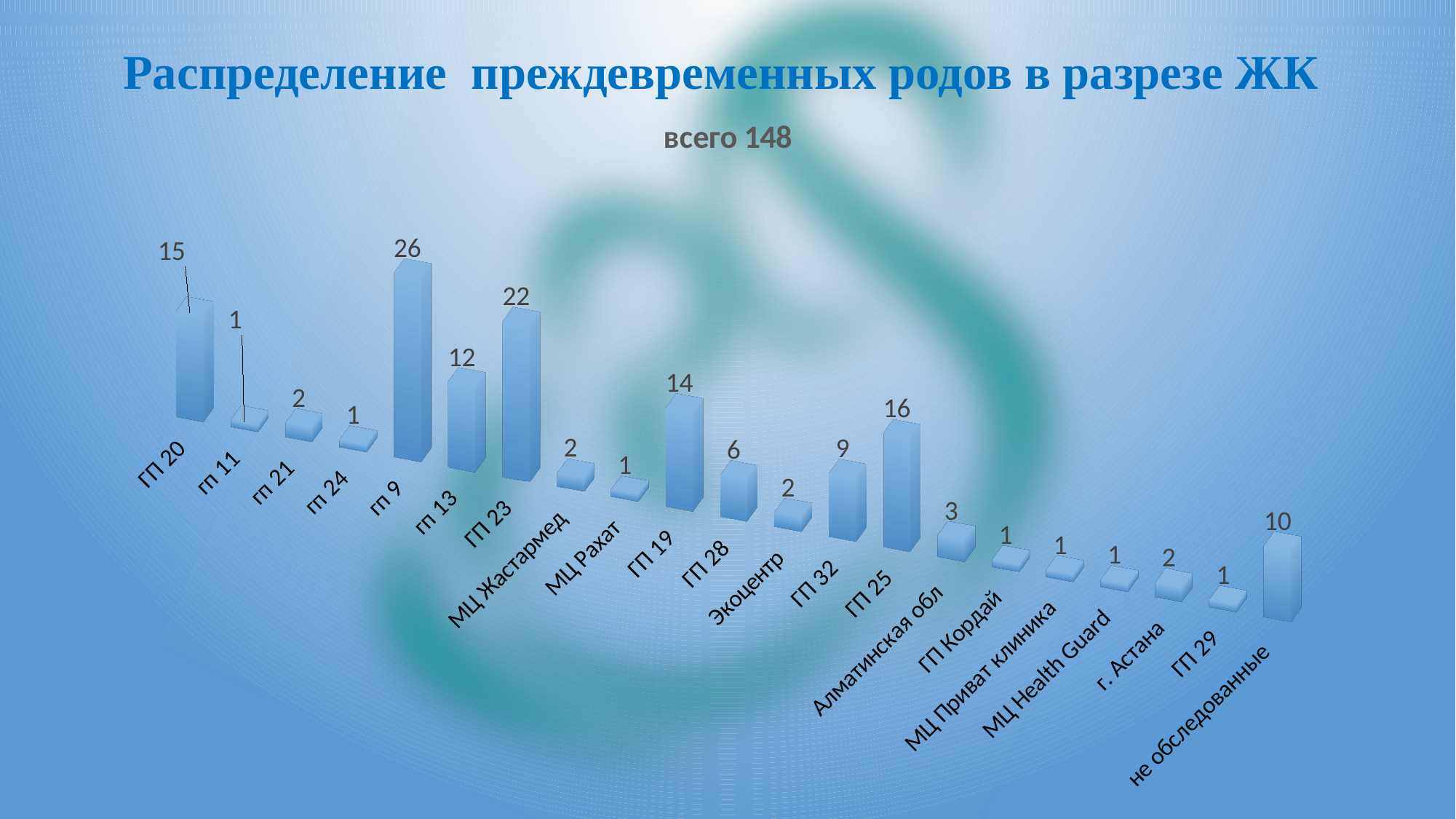
What is the value for гп 9? 26 Which is larger, the value for ГП 19 or the value for ГП 32? ГП 19 Which is larger, the value for гп 13 or the value for ГП 25? ГП 25 What is the difference between the values for ГП 20 and ГП 28? 9 What kind of chart is shown on the slide? bar chart What total is stated in the chart title? всего 148 What is the difference between the values for гп 9 and ГП 23? 4 Which category has the highest value? гп 9 What is the value for не обследованные? 10 What is the value for ГП 25? 16 How many categories are shown in the chart? 21 What is the value for ГП 23? 22